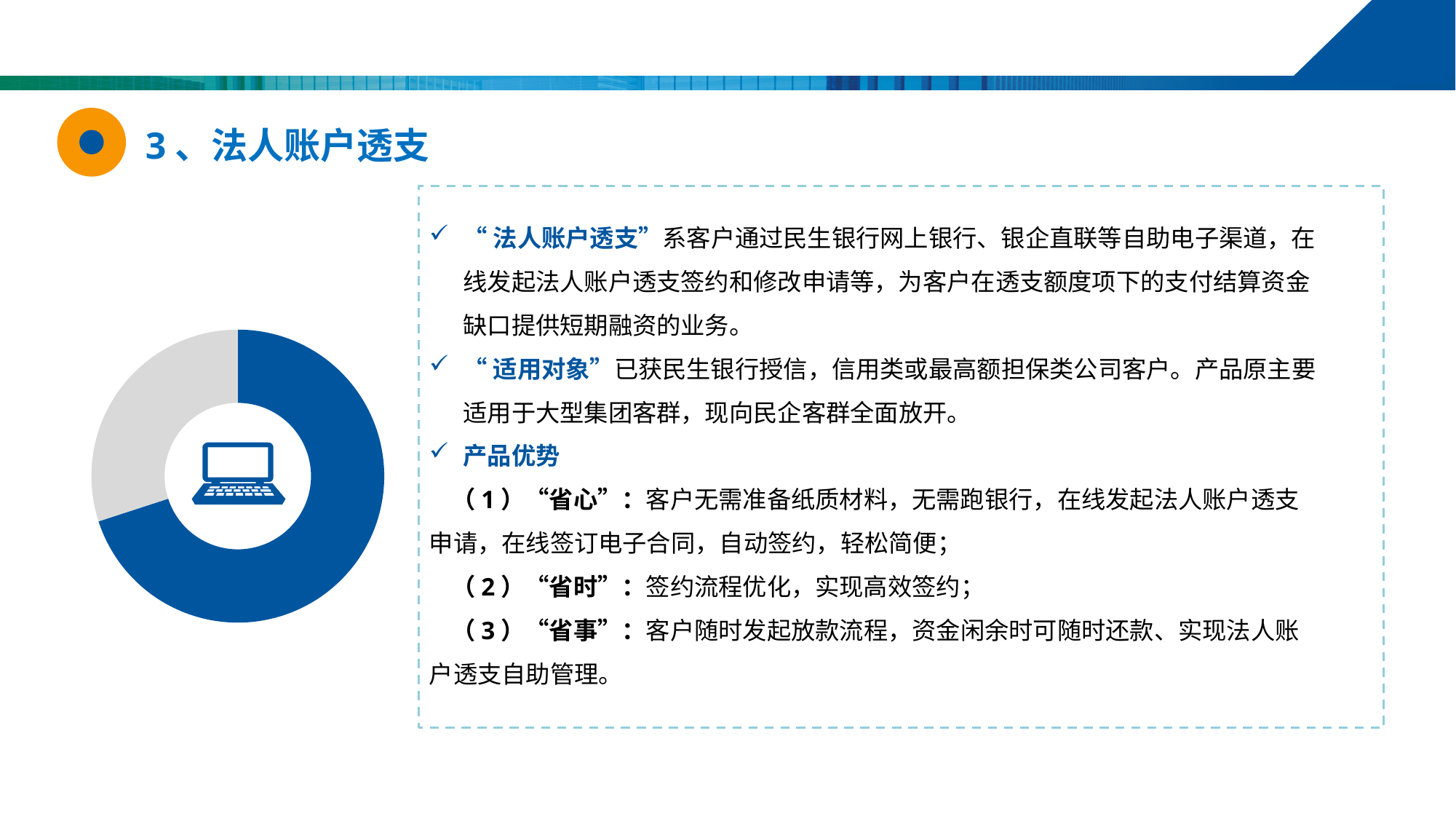
Does the doughnut chart on the left of the slide show any data labels or a legend? No What kind of chart is shown on the left of the slide? doughnut chart How many slices does the doughnut chart on the left of the slide have? 2 What icon is placed in the centre of the doughnut chart on the left of the slide? a laptop In the doughnut chart on the left of the slide, which slice is larger, the blue one or the grey one? the blue one